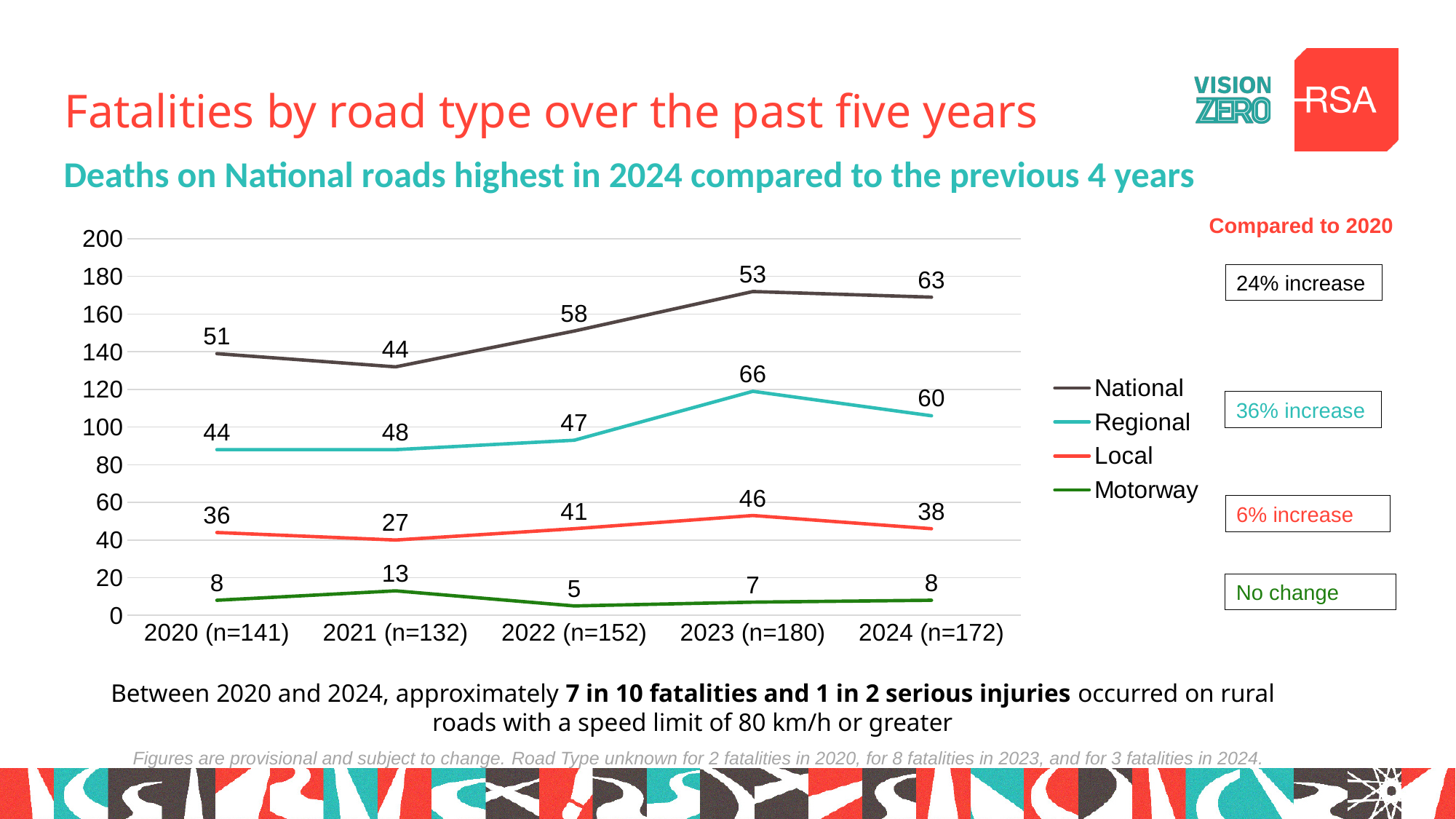
What is the value for National in 2024 (n=172)? 63 According to the 'Compared to 2020' boxes, what is the change for Regional roads? 36% increase In which year is the Motorway series lowest? 2022 (n=152) Which is larger in 2023 (n=180): the Regional value or the National value? Regional What is the value for Motorway in 2022 (n=152)? 5 In which year is the National series highest? 2024 (n=172) How many series does the legend list? 4 What is the value for Local in 2021 (n=132)? 27 How many years are shown on the x axis? 5 What is the value for Regional in 2023 (n=180)? 66 What is the difference between the National value in 2024 (n=172) and in 2020 (n=141)? 12 What type of chart is shown on the slide? Line chart